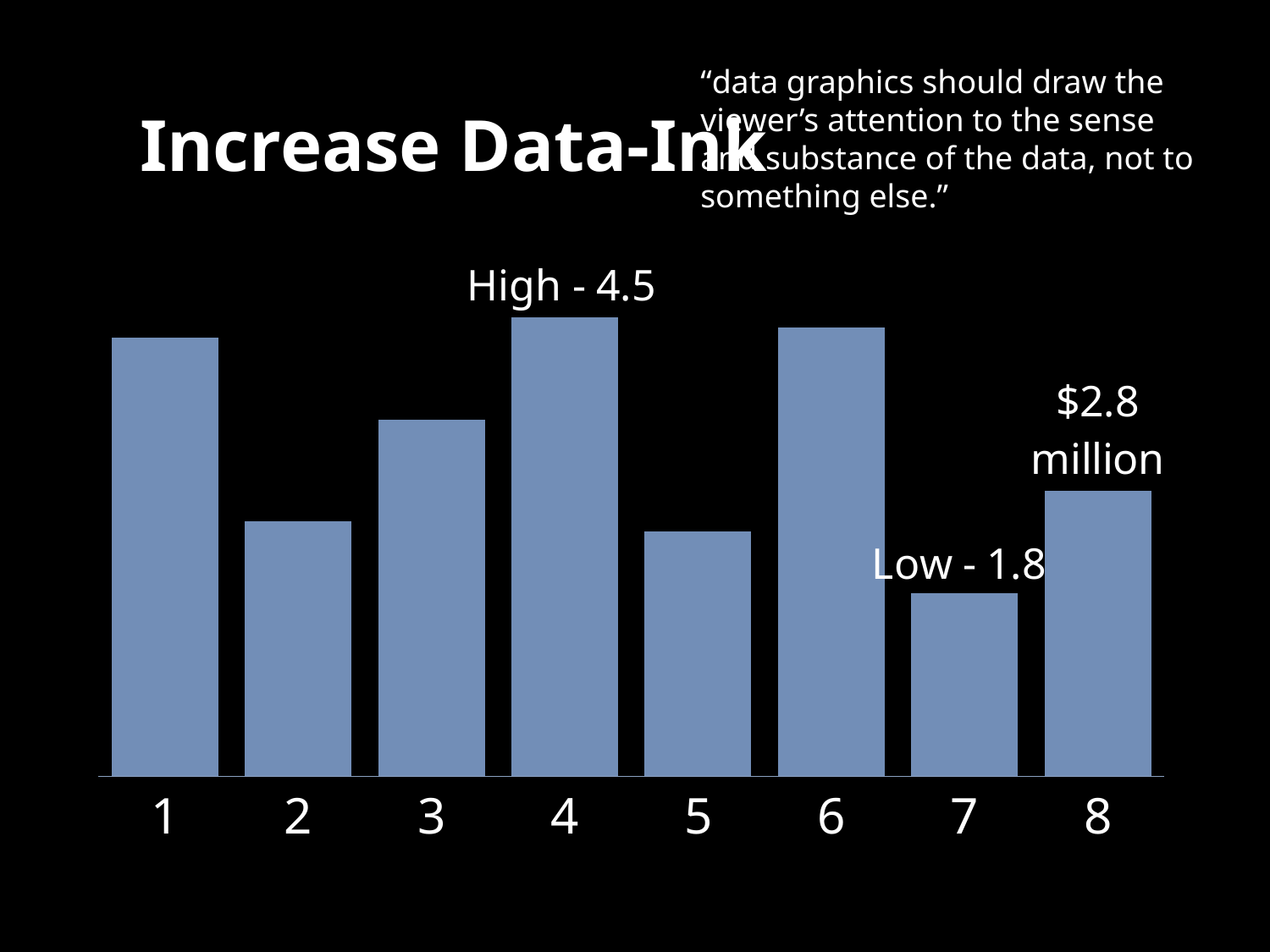
Which category has the lowest bar? 7 What value is labelled for category 7? 1.8 What value is labelled for category 4? 4.5 What kind of chart is shown on the slide? bar chart Which is larger, the bar for category 3 or the bar for category 5? 3 What is the title of the slide containing the chart? Increase Data-Ink Which is larger, the bar for category 6 or the bar for category 8? 6 Which is larger, the bar for category 1 or the bar for category 2? 1 How many bars are plotted in the chart? 8 What value is labelled for category 8? $2.8 million Which category has the highest bar? 4 What is the difference between the high value (category 4) and the low value (category 7)? 2.7